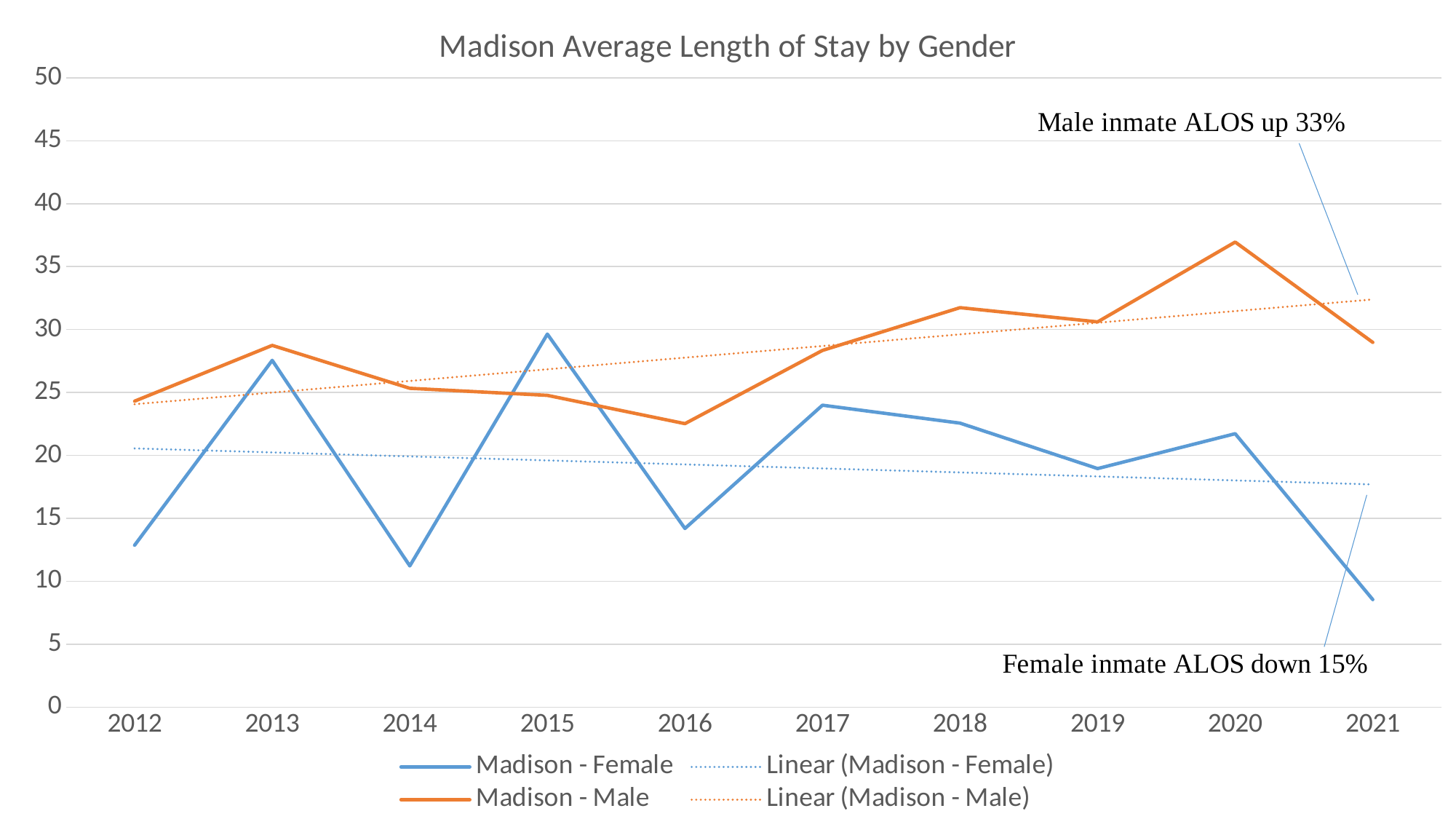
In which year is the Madison - Female value lowest? 2021 In 2015, which series has the larger value, Madison - Female or Madison - Male? Madison - Female Is the Madison - Male value for 2020 greater or less than 35? greater How many entries does the legend list? 4 Is the Madison - Male value for 2018 greater or less than 30? greater In which year is the Madison - Male value highest? 2020 Is the Madison - Female value for 2021 greater or less than 10? less In which year is the Madison - Female value highest? 2015 What kind of chart is shown on the slide? line chart How many years are plotted along the x axis? 10 Does the Linear (Madison - Male) trendline rise or fall from 2012 to 2021? rise What is the title of the chart? Madison Average Length of Stay by Gender